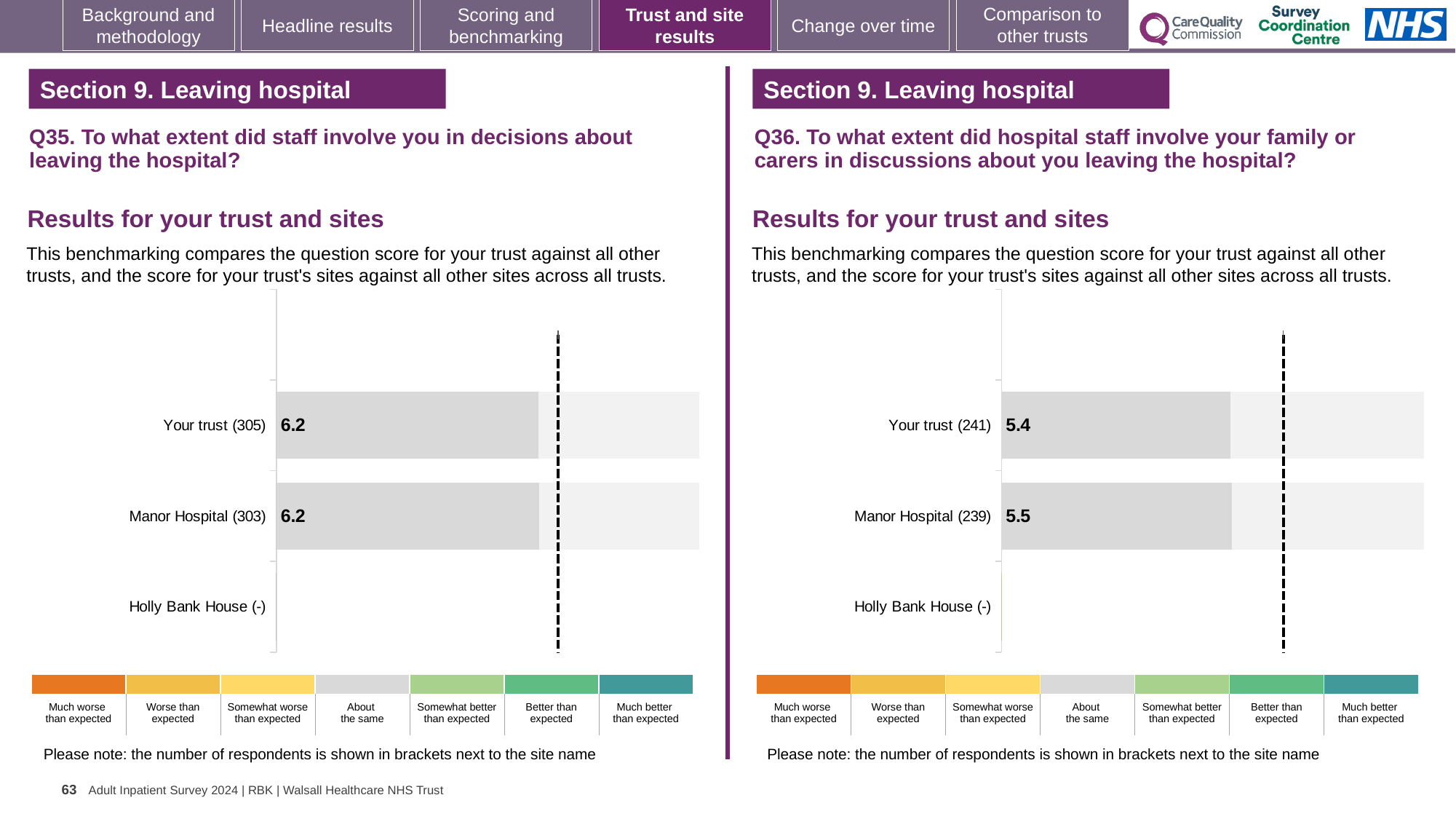
In the Q36 chart on the right, which has the higher score, Your trust or Manor Hospital? Manor Hospital In the Q36 chart on the right, how many respondents are shown in brackets for Manor Hospital? 239 How many benchmark categories does the colour legend below the Q35 chart on the left list? 7 In the Q36 chart on the right, what is the difference between the Manor Hospital score and the Your trust score? 0.1 In the Q36 chart on the right, what is the score for Manor Hospital? 5.5 What kind of chart is used for the Q36 results on the right? Bar chart How many sites or categories are listed on the y axis of the Q35 chart on the left? 3 In the Q36 chart on the right, what is the score for Your trust? 5.4 In the Q35 chart on the left, how many respondents are shown in brackets for Your trust? 305 In the Q35 chart on the left, what is the difference between the Your trust score and the Manor Hospital score? 0 In the Q35 chart on the left, what is the score for Manor Hospital? 6.2 In the Q35 chart on the left, what is the score for Your trust? 6.2